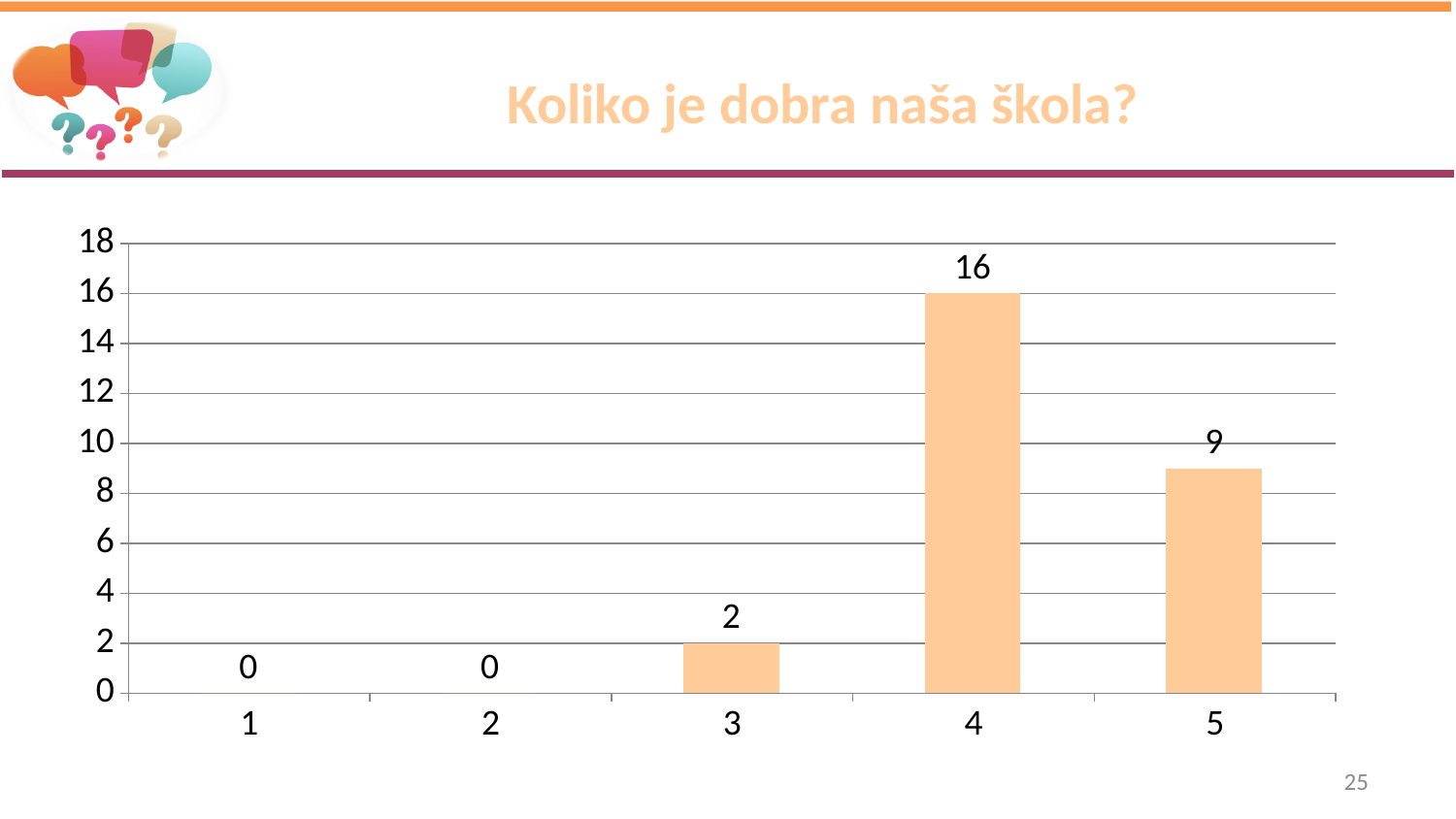
What is the value for category 5? 9 What is the title of the slide? Koliko je dobra naša škola? What is the value for category 1? 0 What is the total of the values for categories 3, 4 and 5? 27 Which is larger, the value for category 3 or the value for category 5? 5 How many categories are shown on the x axis? 5 What kind of chart is shown on the slide? bar chart What is the value for category 4? 16 Is the value for category 4 greater or less than 14? greater Which category has the highest value? 4 What is the difference between the values for categories 4 and 5? 7 What is the value for category 3? 2